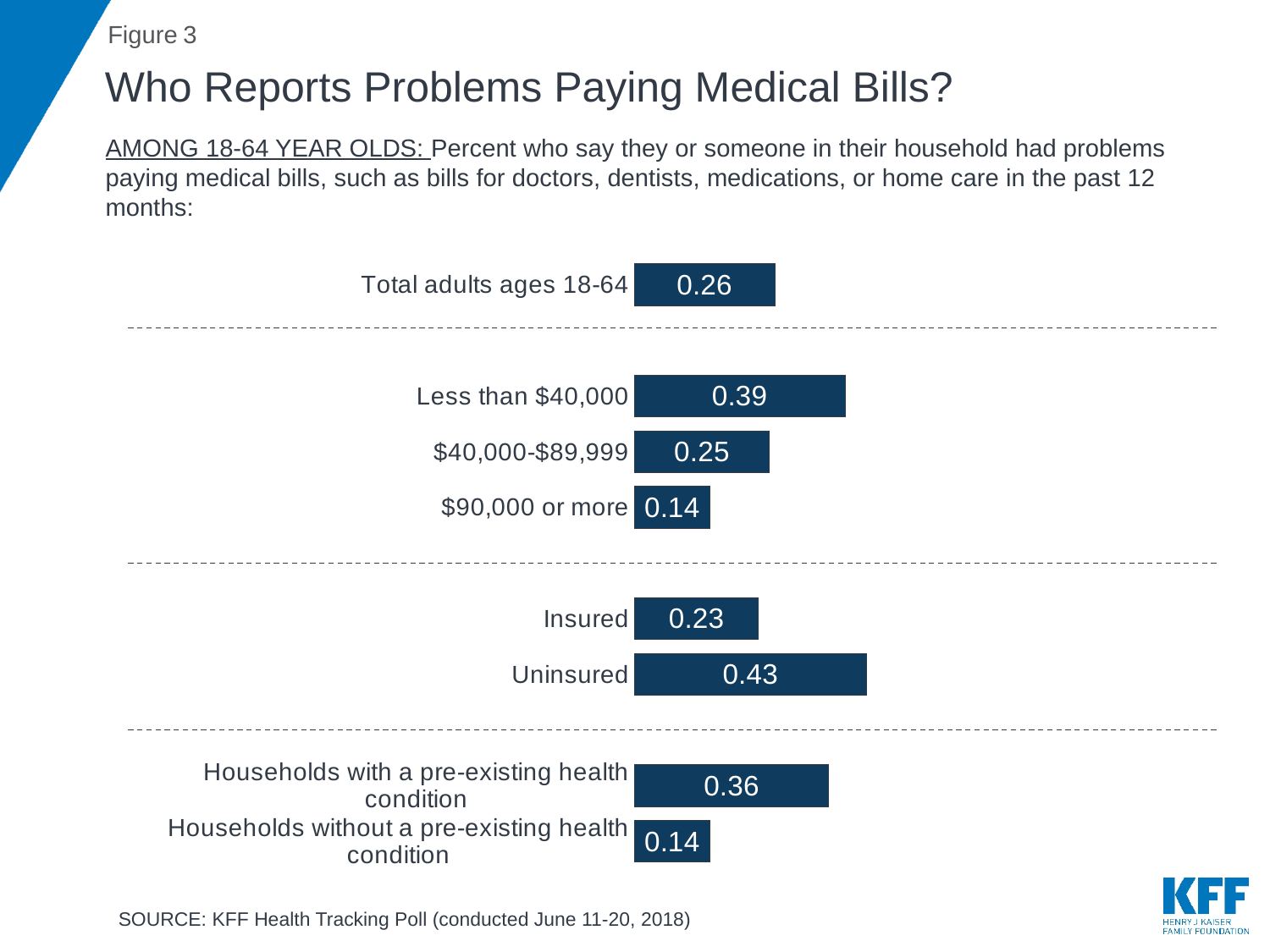
What kind of chart is shown on the slide? Bar chart What is the difference between the values for Uninsured and Insured? 0.20 Which is larger, the value for Households with a pre-existing health condition or Households without a pre-existing health condition? Households with a pre-existing health condition What is the value for Households with a pre-existing health condition? 0.36 What is the title of the slide's chart? Who Reports Problems Paying Medical Bills? What is the value for Less than $40,000? 0.39 How many categories are plotted in the chart? 8 Which income group has the lowest value? $90,000 or more Which category has the highest value? Uninsured What is the value for Uninsured? 0.43 What is the difference between the values for Less than $40,000 and $90,000 or more? 0.25 What is the value for Total adults ages 18-64? 0.26